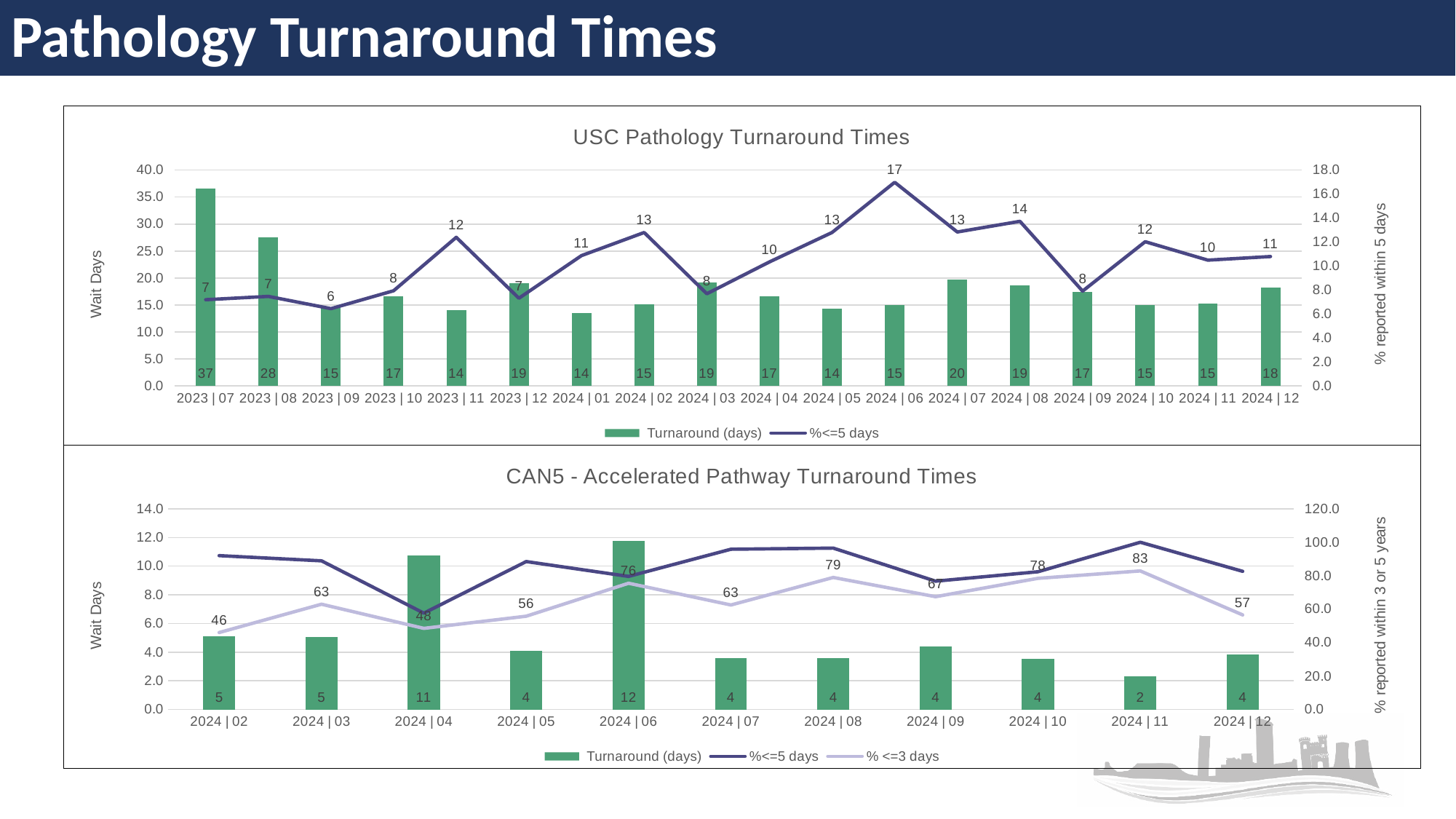
In the USC Pathology Turnaround Times chart, which month has the highest Turnaround (days) value? 2023 | 07 How many months are plotted on the x axis of the USC Pathology Turnaround Times chart? 18 In the USC Pathology Turnaround Times chart, what is the difference between the Turnaround (days) values for 2023 | 07 and 2023 | 08? 9 In the USC Pathology Turnaround Times chart, what is the Turnaround (days) value for 2023 | 07? 37 In the USC Pathology Turnaround Times chart, what is the %<=5 days value for 2024 | 06? 17 In the CAN5 - Accelerated Pathway Turnaround Times chart, is the %<=5 days value for 2024 | 07 greater or less than 80.0? greater In the CAN5 - Accelerated Pathway Turnaround Times chart, which month has the lowest Turnaround (days) value? 2024 | 11 How many series does the legend of the CAN5 - Accelerated Pathway Turnaround Times chart list? 3 How many series does the legend of the USC Pathology Turnaround Times chart list? 2 In the CAN5 - Accelerated Pathway Turnaround Times chart, what is the % <=3 days value for 2024 | 11? 83 In the CAN5 - Accelerated Pathway Turnaround Times chart, what is the Turnaround (days) value for 2024 | 06? 12 What kind of chart is the CAN5 - Accelerated Pathway Turnaround Times chart? Combined bar and line chart